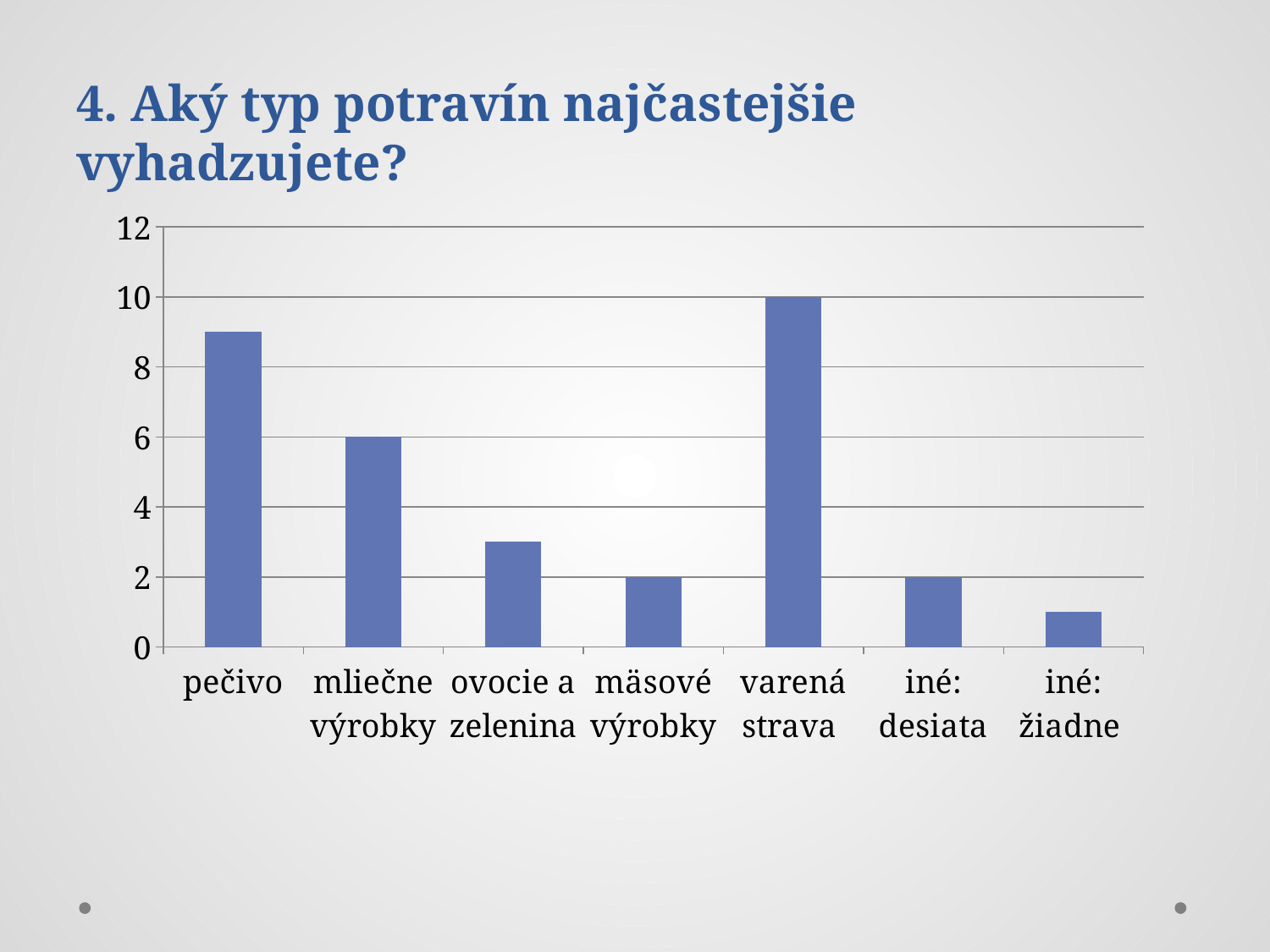
Is the value for ovocie a zelenina greater or less than 4? less What is the value for varená strava? 10 Is the value for pečivo greater or less than 8? greater What is the difference between the values for varená strava and mliečne výrobky? 4 What type of chart is shown on the slide? bar chart Which category has the highest value in the chart? varená strava Which category has the lowest value in the chart? iné: žiadne What is the title of the slide above the chart? 4. Aký typ potravín najčastejšie vyhadzujete? How many categories are shown on the x axis of the chart? 7 Which is larger, the value for pečivo or the value for mliečne výrobky? pečivo What is the value for mliečne výrobky? 6 What is the value for mäsové výrobky? 2